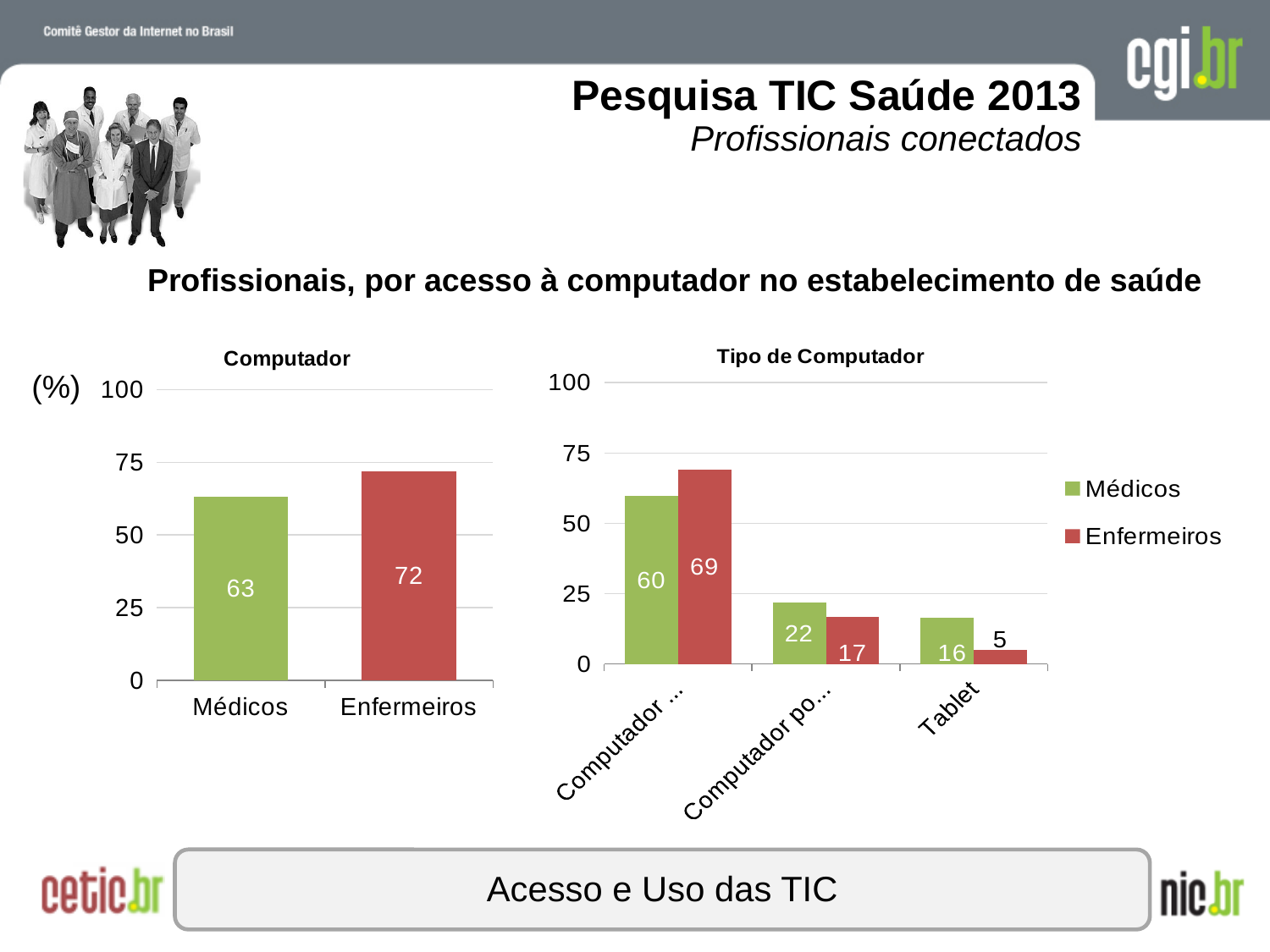
In the 'Computador' chart, which category has the higher value? Enfermeiros How many categories are shown on the x axis of the 'Tipo de Computador' chart? 3 How many series does the legend of the 'Tipo de Computador' chart list? 2 What kind of chart is the 'Computador' chart? bar chart In the 'Tipo de Computador' chart, what is the difference between the Médicos and Enfermeiros values for Tablet? 11 In the 'Computador' chart, what is the value for Enfermeiros? 72 In the 'Tipo de Computador' chart, which series has the larger value in the Tablet category, Médicos or Enfermeiros? Médicos In the 'Computador' chart, what is the difference between the values for Enfermeiros and Médicos? 9 In the 'Computador' chart, is the value for Médicos greater or less than 50? greater In the 'Computador' chart, what is the value for Médicos? 63 In the 'Tipo de Computador' chart, what is the value for Médicos in the Tablet category? 16 In the 'Tipo de Computador' chart, what is the value for Enfermeiros in the Tablet category? 5